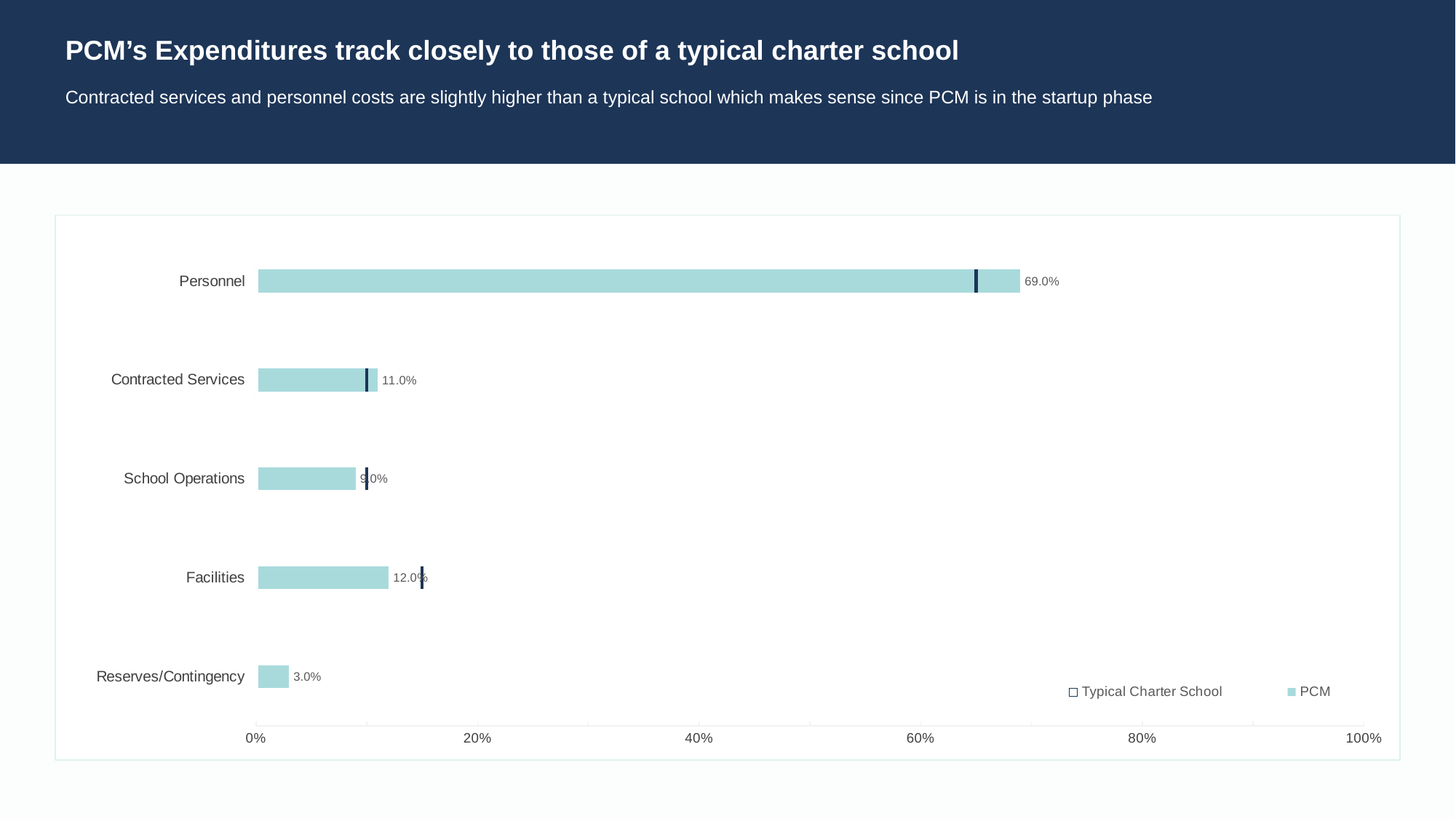
Which category has the highest PCM value? Personnel What kind of chart is shown on the slide? Bar chart What is the difference between the PCM values for Personnel and Contracted Services? 58.0% What is the PCM value for Contracted Services? 11.0% What is the PCM value for Facilities? 12.0% Which has a larger PCM value, Facilities or School Operations? Facilities How many expenditure categories are shown on the chart? 5 What is the PCM value for Personnel? 69.0% What is the PCM value for Reserves/Contingency? 3.0% How many series does the legend list? 2 Which category has the lowest PCM value? Reserves/Contingency Is the Typical Charter School value for Personnel greater or less than 60%? greater